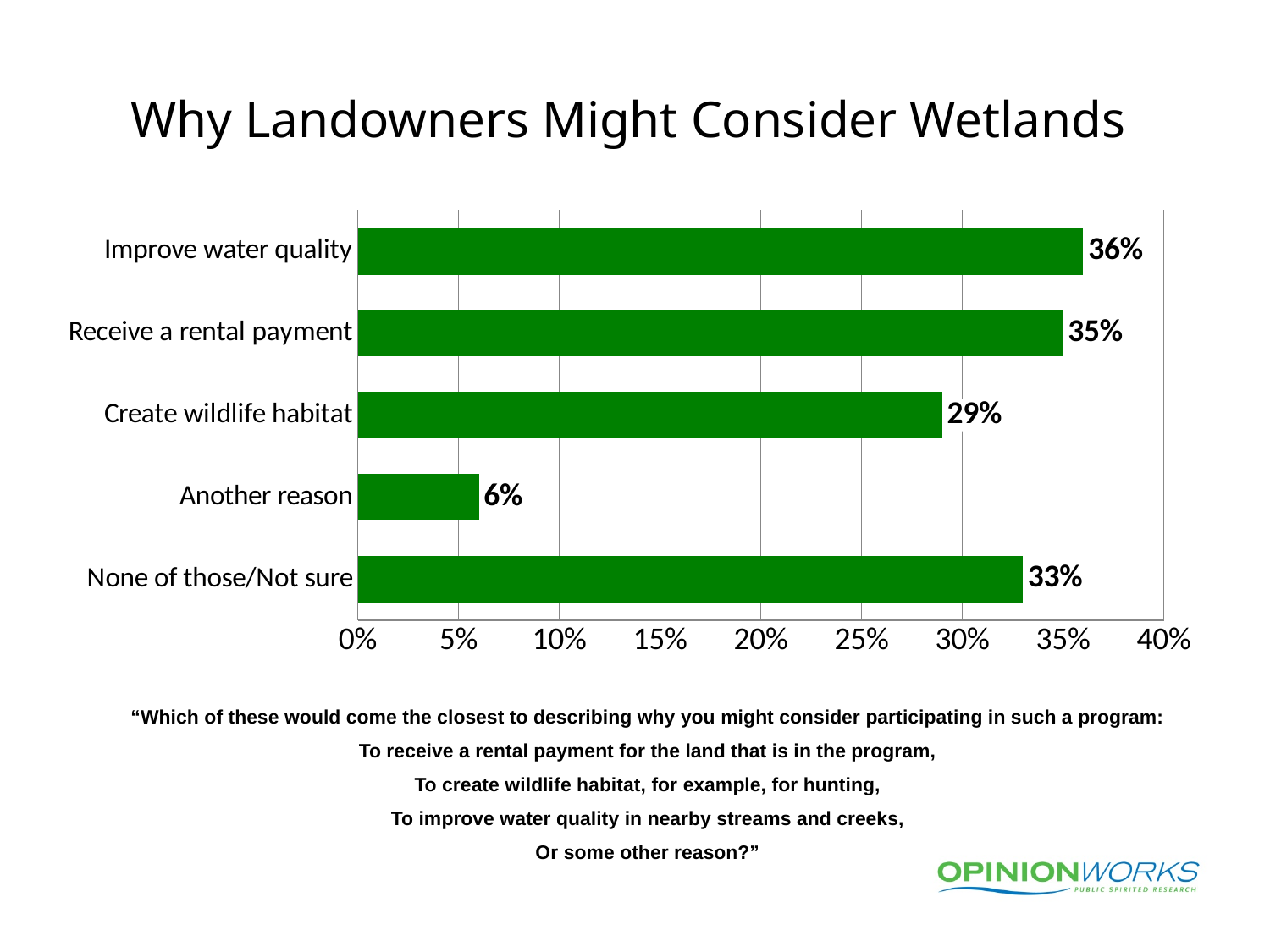
What is the value for "Receive a rental payment"? 35% What is the value for "None of those/Not sure"? 33% Which category has the lowest value? Another reason What kind of chart is shown on the slide? Bar chart Which is larger, "Create wildlife habitat" or "None of those/Not sure"? None of those/Not sure What is the title of the chart? Why Landowners Might Consider Wetlands What is the difference between "Improve water quality" and "Create wildlife habitat"? 7% What is the difference between "None of those/Not sure" and "Another reason"? 27% What is the value for "Create wildlife habitat"? 29% How many categories are shown in the chart? 5 What is the value for "Another reason"? 6% What percentage of landowners cited improving water quality as a reason to consider wetlands? 36%